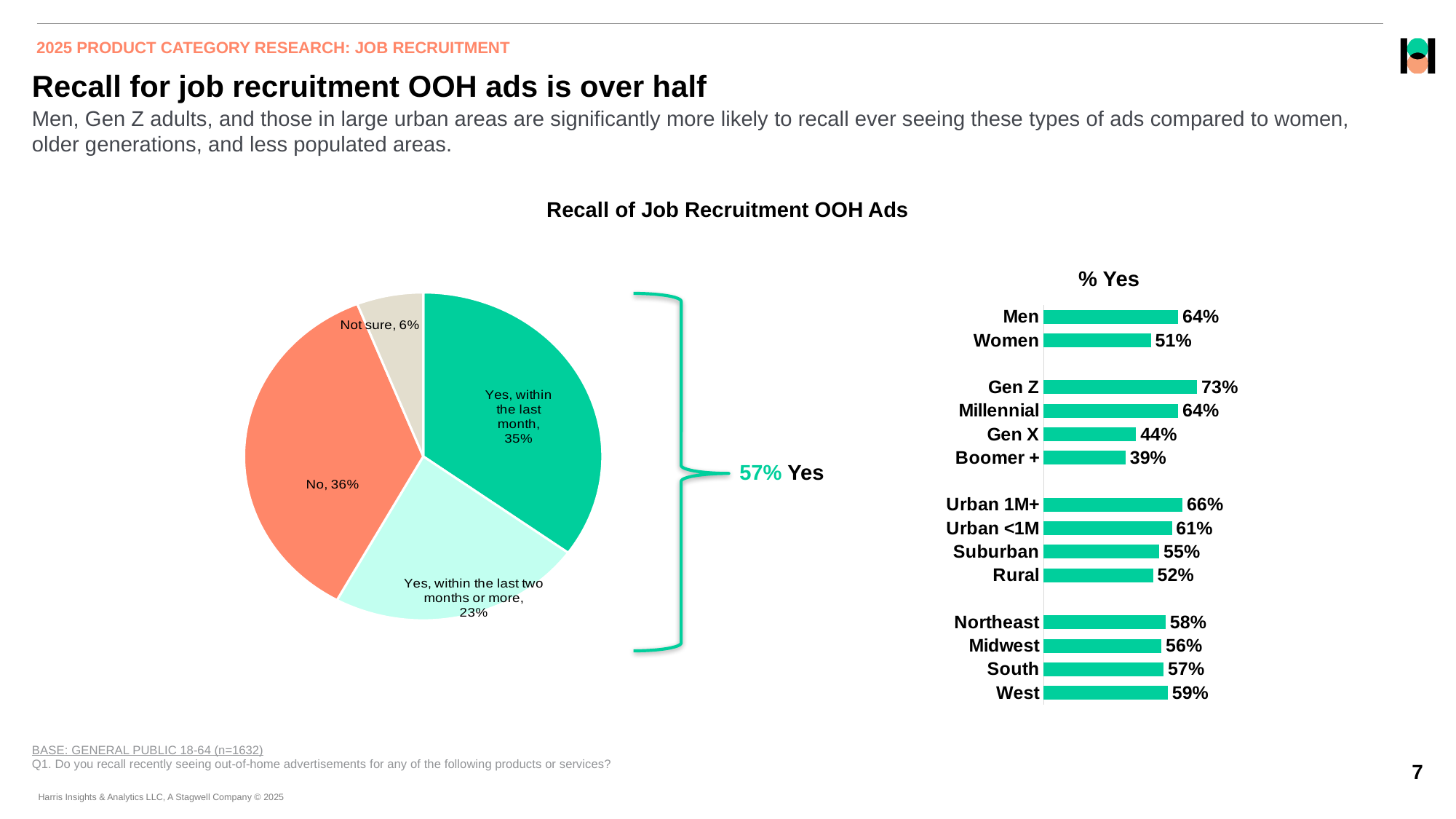
In the "% Yes" bar chart, which category has the highest value? Gen Z In the pie chart, which slice is the smallest? Not sure In the "% Yes" bar chart, what is the value for Rural? 52% In the "% Yes" bar chart, what is the difference between Men and Women? 13% In the pie chart, what share of respondents answered "No"? 36% How many slices does the pie chart have? 4 In the pie chart, what share answered "Yes, within the last month"? 35% In the "% Yes" bar chart, what is the value for Gen Z? 73% What type of chart is the "% Yes" chart on the right? Bar chart In the "% Yes" bar chart, which is larger, Urban 1M+ or Suburban? Urban 1M+ In the "% Yes" bar chart, which category has the lowest value? Boomer + What is the title of the chart section on the slide? Recall of Job Recruitment OOH Ads